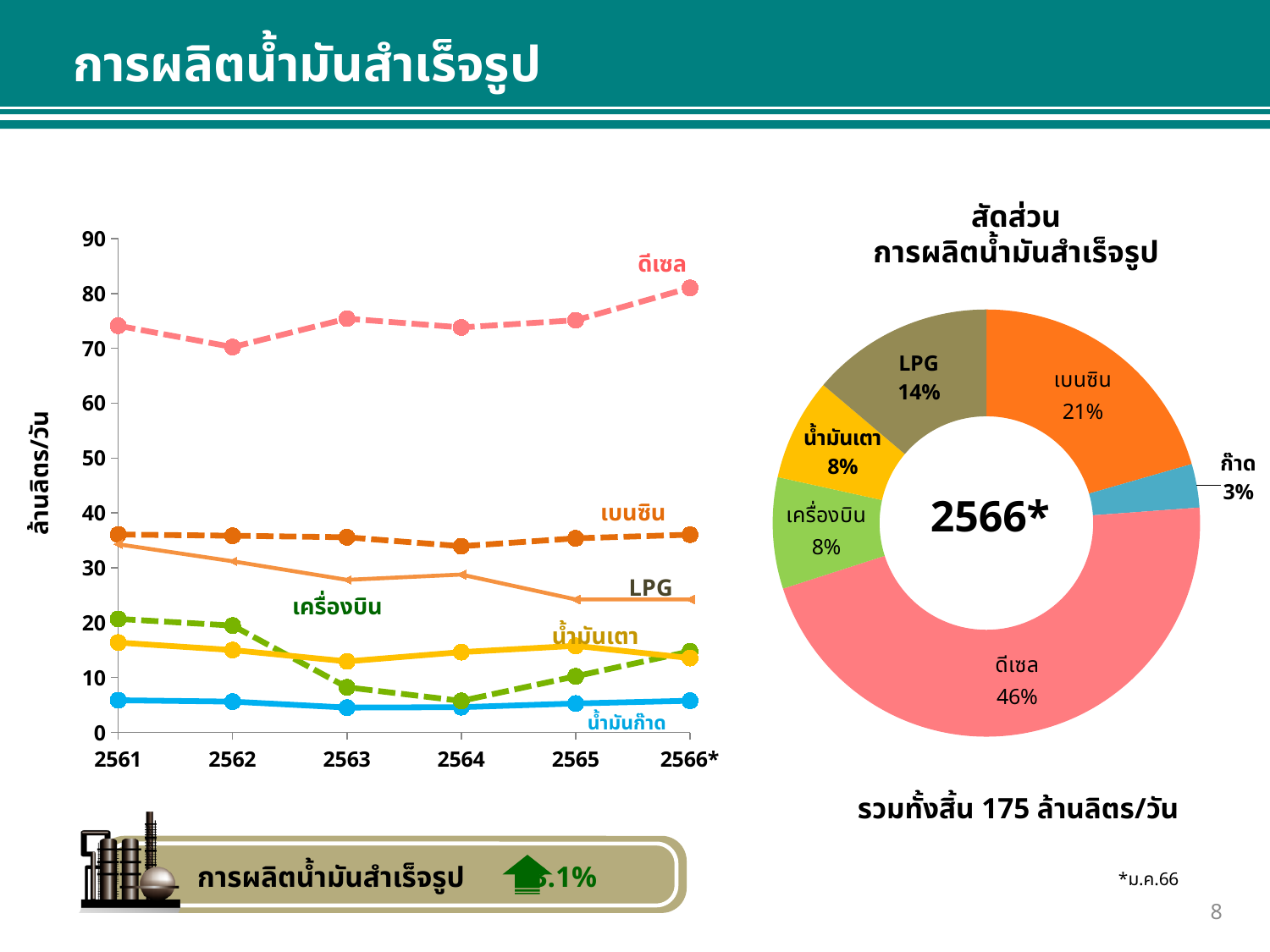
In the line chart on the left, is the value for ดีเซล in 2561 greater or less than 70? greater In the pie chart titled สัดส่วนการผลิตน้ำมันสำเร็จรูป, which category has the largest slice? ดีเซล In the pie chart titled สัดส่วนการผลิตน้ำมันสำเร็จรูป, what share does ดีเซล have? 46% In the pie chart titled สัดส่วนการผลิตน้ำมันสำเร็จรูป, which is larger, the share of LPG or the share of น้ำมันเตา? LPG In the pie chart titled สัดส่วนการผลิตน้ำมันสำเร็จรูป, what share does เบนซิน have? 21% In the pie chart titled สัดส่วนการผลิตน้ำมันสำเร็จรูป, how many percentage points larger is the ดีเซล share than the เบนซิน share? 25 percentage points In the line chart on the left, how many years are shown on the x axis? 6 What kind of chart is the chart on the left side of the slide? Line chart In the pie chart titled สัดส่วนการผลิตน้ำมันสำเร็จรูป, how many slices are there? 6 In the pie chart titled สัดส่วนการผลิตน้ำมันสำเร็จรูป, which category has the smallest slice? ก๊าด In the line chart on the left, does the เครื่องบิน series rise or fall from 2561 to 2564? fall In the line chart on the left, how many series are plotted? 6